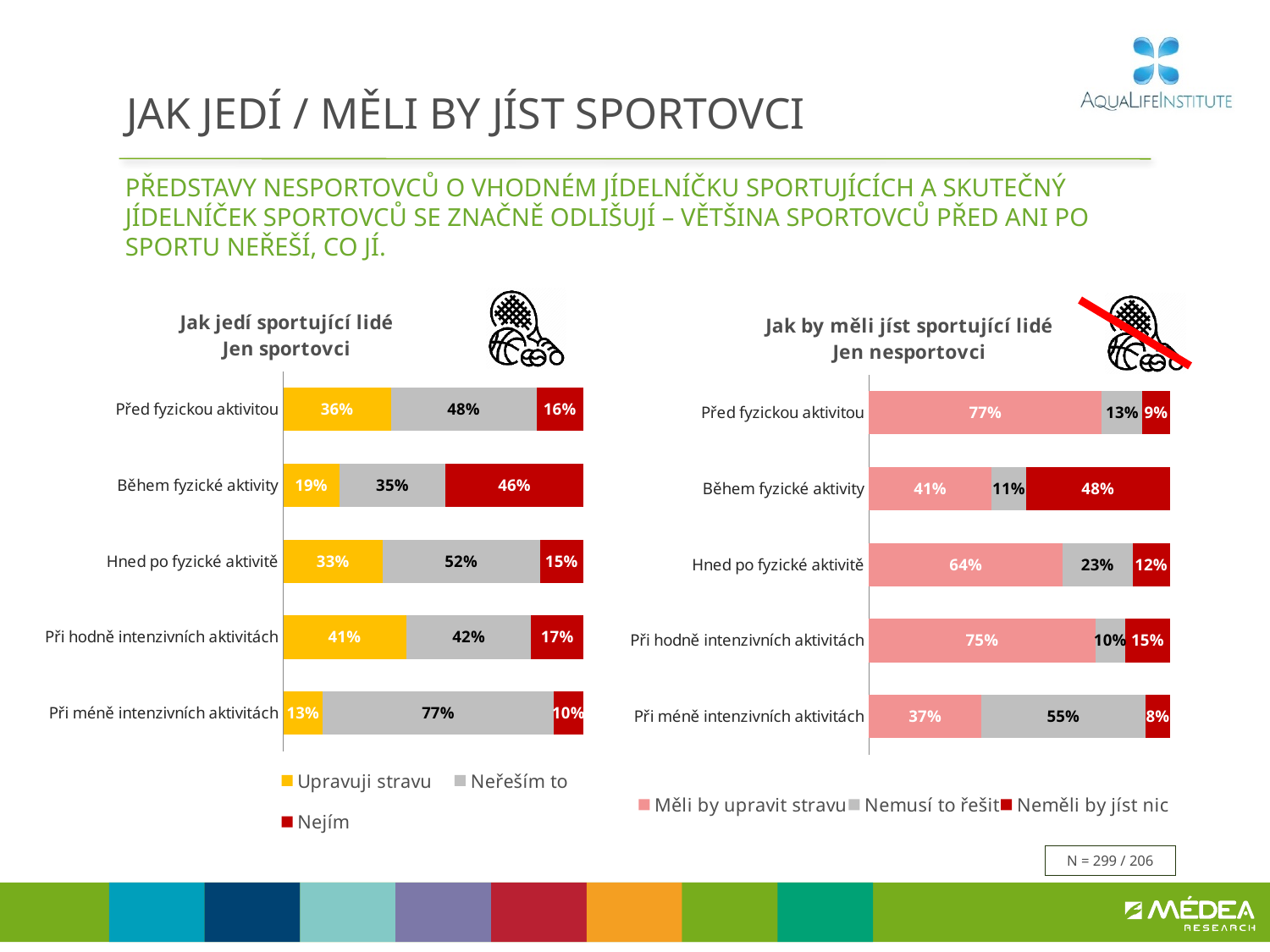
In the right chart 'Jak by měli jíst sportující lidé – Jen nesportovci', what is the total of the stacked bar for 'Před fyzickou aktivitou'? 99% In the left chart 'Jak jedí sportující lidé – Jen sportovci', which category has the highest 'Neřeším to' value? Při méně intenzivních aktivitách In the left chart 'Jak jedí sportující lidé – Jen sportovci', what is the difference between the 'Upravuji stravu' values for 'Při hodně intenzivních aktivitách' and 'Při méně intenzivních aktivitách'? 28% In the left chart 'Jak jedí sportující lidé – Jen sportovci', what is the value of 'Nejím' for 'Během fyzické aktivity'? 46% In the right chart 'Jak by měli jíst sportující lidé – Jen nesportovci', what is the value of 'Nemusí to řešit' for 'Při méně intenzivních aktivitách'? 55% In the left chart 'Jak jedí sportující lidé – Jen sportovci', what is the value of 'Upravuji stravu' for 'Před fyzickou aktivitou'? 36% In the right chart 'Jak by měli jíst sportující lidé – Jen nesportovci', which is larger for 'Během fyzické aktivity': 'Měli by upravit stravu' or 'Neměli by jíst nic'? Neměli by jíst nic How many series does the legend of the right chart 'Jak by měli jíst sportující lidé – Jen nesportovci' list? 3 How many categories are shown in the left chart 'Jak jedí sportující lidé – Jen sportovci'? 5 What type of chart is the left chart 'Jak jedí sportující lidé – Jen sportovci'? Stacked bar chart In the right chart 'Jak by měli jíst sportující lidé – Jen nesportovci', which category has the lowest 'Měli by upravit stravu' value? Při méně intenzivních aktivitách In the right chart 'Jak by měli jíst sportující lidé – Jen nesportovci', what is the value of 'Měli by upravit stravu' for 'Hned po fyzické aktivitě'? 64%